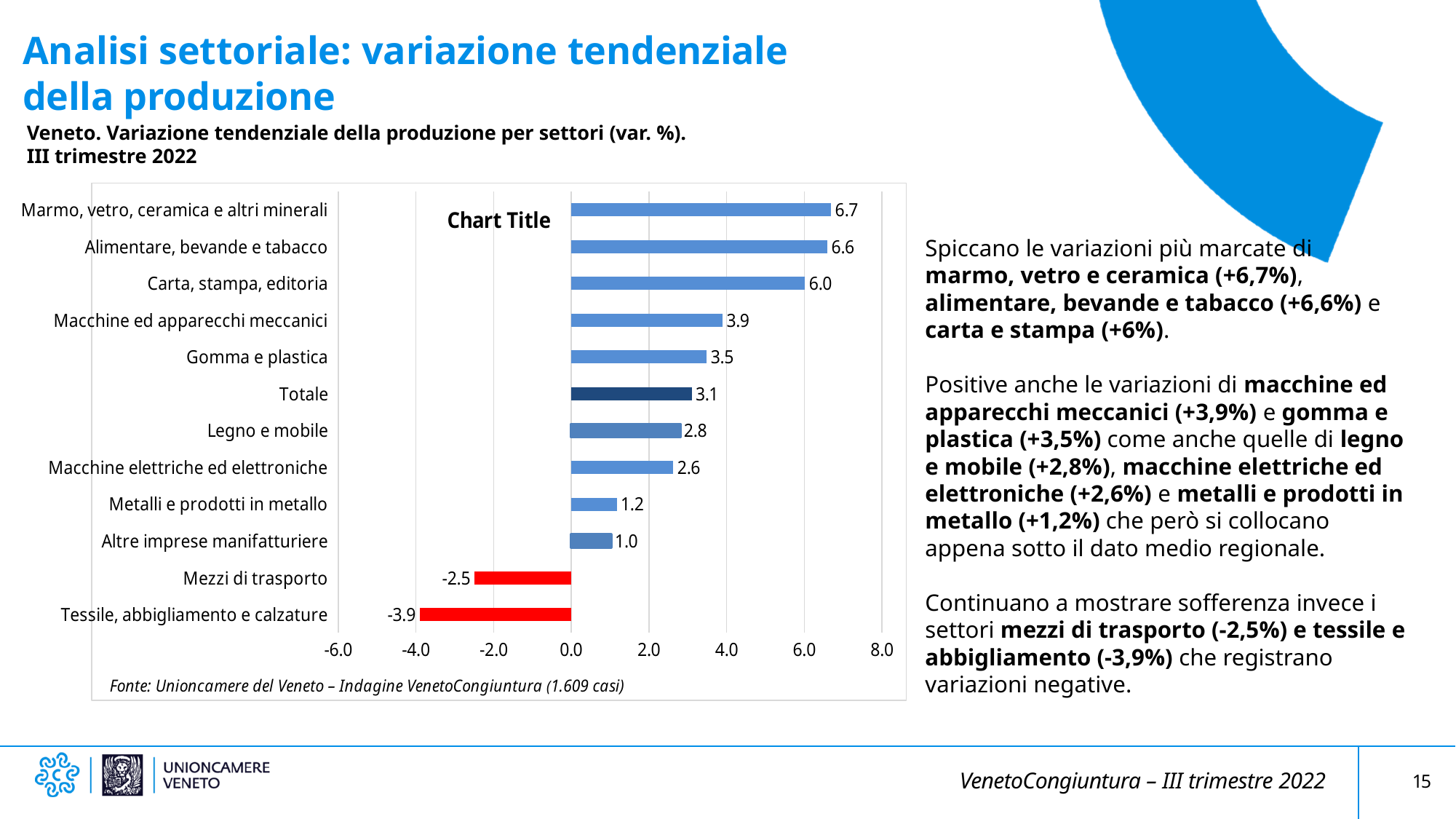
What is the value for Marmo, vetro, ceramica e altri minerali? 6.7 Which category has the highest value? Marmo, vetro, ceramica e altri minerali How many bars are shown in red? 2 What is the difference between the values for Carta, stampa, editoria and Gomma e plastica? 2.5 What is the value for Totale? 3.1 What is the value for Metalli e prodotti in metallo? 1.2 Which category has the lowest value? Tessile, abbigliamento e calzature How many categories are shown in the chart? 12 What kind of chart is shown on the slide? bar chart Is the value for Macchine ed apparecchi meccanici greater or less than 2.0? greater Which is larger, the value for Legno e mobile or the value for Macchine elettriche ed elettroniche? Legno e mobile What is the value for Mezzi di trasporto? -2.5